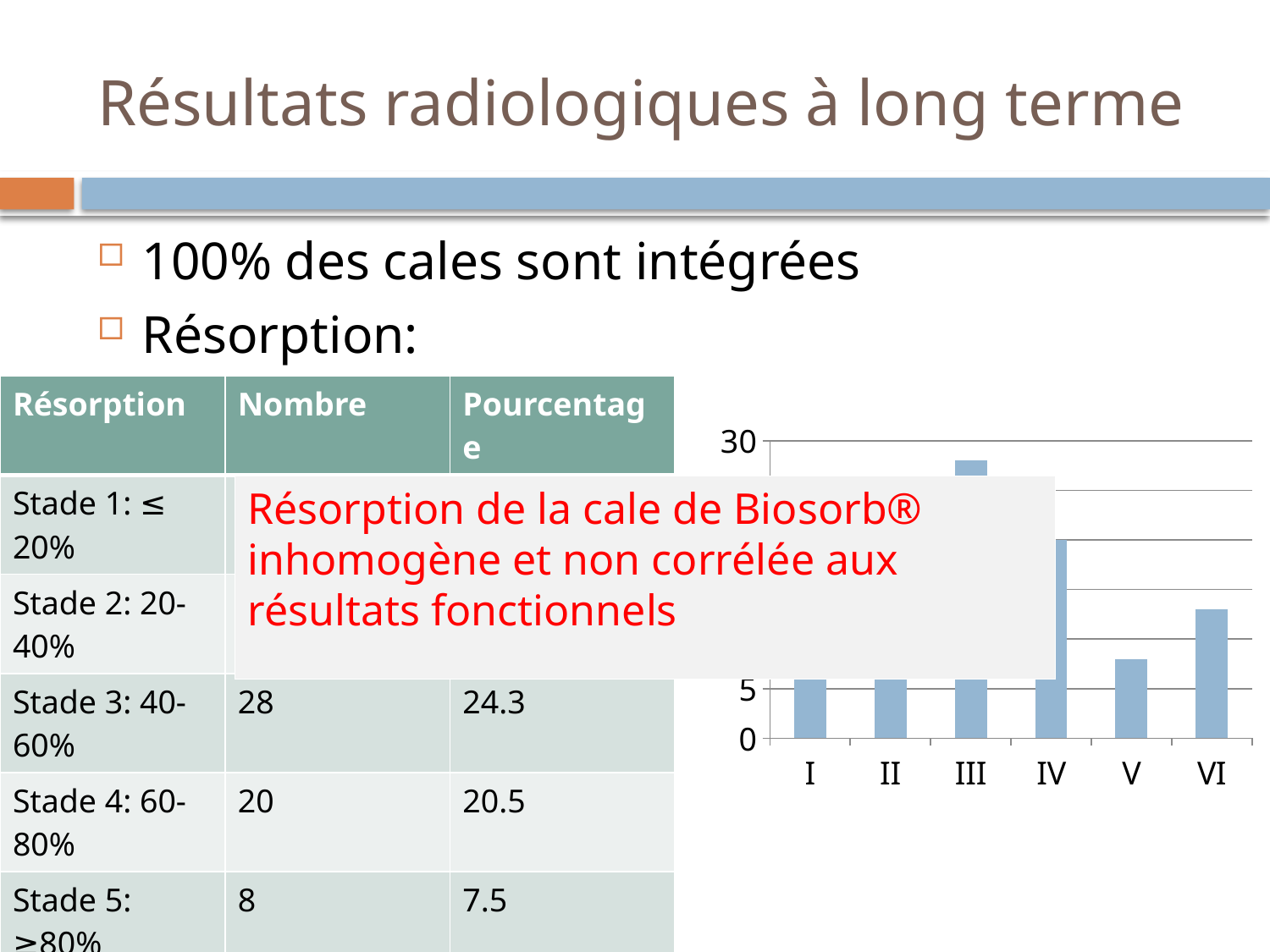
Is the value for category III greater or less than 30? less What kind of chart is shown on the slide? bar chart What is the highest value labelled on the y axis of the chart? 30 Is the value for category III greater or less than 5? greater Which is larger, the bar for category III or the bar for category VI? III Which category has the highest bar in the chart? III Which is larger, the bar for category VI or the bar for category V? VI Is the value for category IV greater or less than 5? greater How many categories are shown on the x axis of the bar chart? 6 Which is larger, the bar for category IV or the bar for category V? IV How are the categories on the x axis of the chart labelled? Roman numerals I to VI